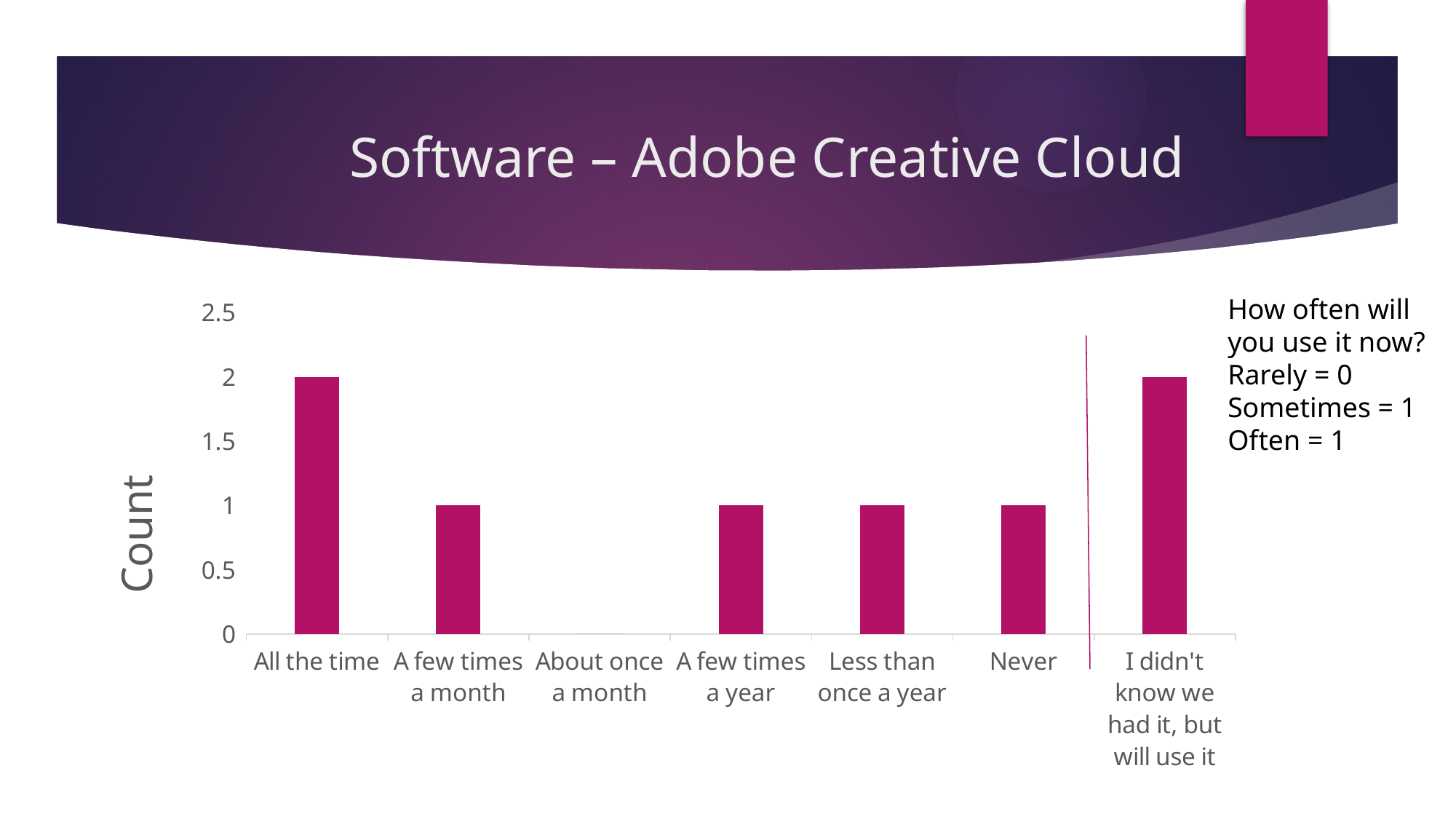
What is the count for "About once a month"? 0 Which category has the lowest count? About once a month What is the count for "I didn't know we had it, but will use it"? 2 Which has a larger count, "All the time" or "Less than once a year"? All the time What is the count for "A few times a month"? 1 How many categories are shown on the x axis? 7 What is the difference between the count for "All the time" and the count for "A few times a year"? 1 Is the count for "Never" greater or less than 1.5? less What is the count for "All the time"? 2 What is the label of the vertical axis? Count What is the count for "Never"? 1 What kind of chart is shown on the slide? Bar chart